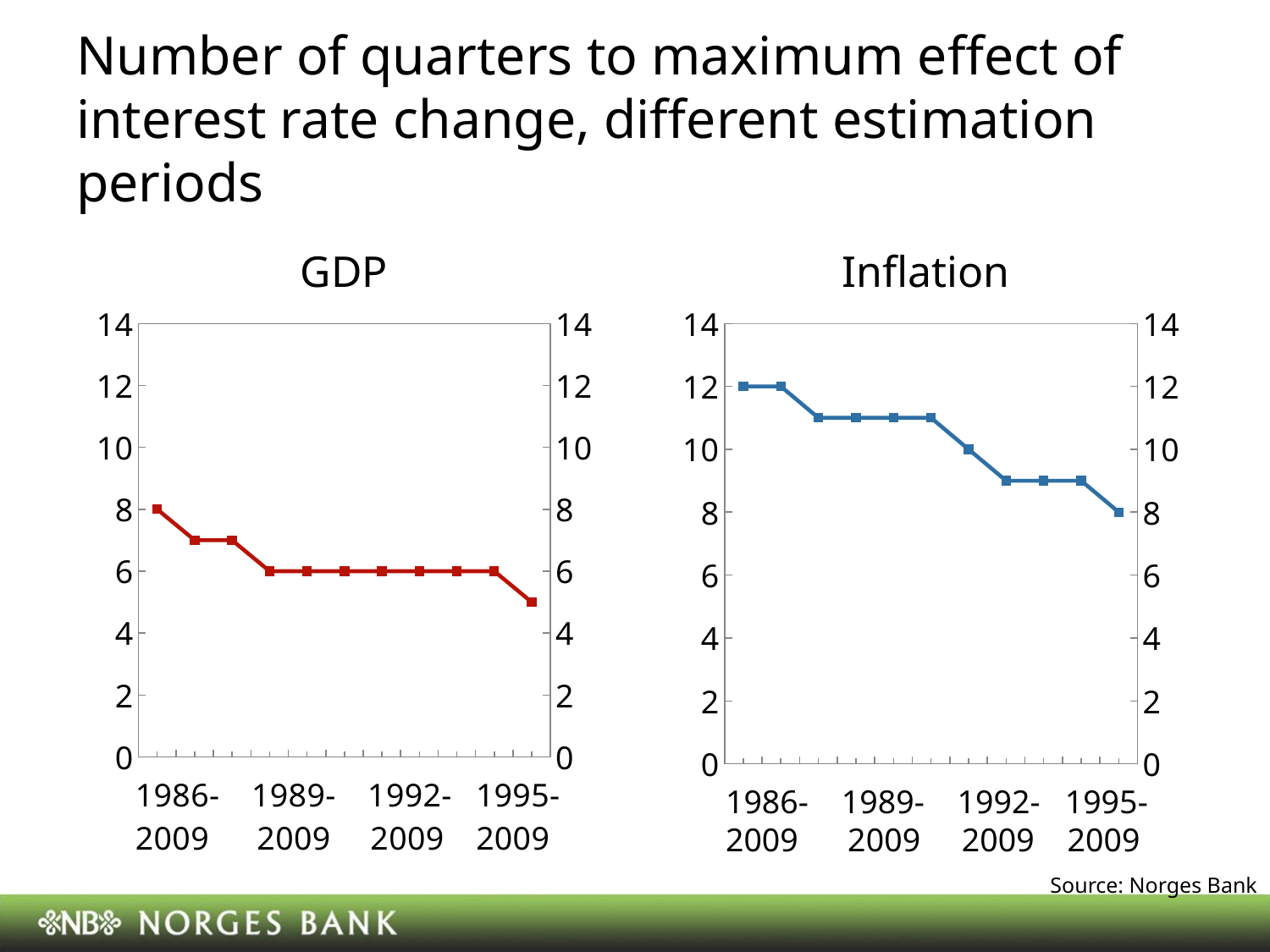
On the GDP chart, what is the difference between the values for 1986-2009 and 1989-2009? 2 On the Inflation chart, do the values rise or fall from left to right along the x axis? fall On the GDP chart, what is the value for the 1989-2009 estimation period? 6 Which is larger for the 1986-2009 period: the GDP chart value or the Inflation chart value? Inflation On the Inflation chart, what is the value for the 1992-2009 estimation period? 10 On the Inflation chart, is the value for 1995-2009 greater or less than 10? less On the GDP chart, which labelled estimation period has the highest value? 1986-2009 On the Inflation chart, what is the difference between the values for 1986-2009 and 1992-2009? 2 On the GDP chart, what is the value for the 1986-2009 estimation period? 8 What kind of chart is the GDP chart? line chart On the Inflation chart, what is the value for the 1986-2009 estimation period? 12 On the GDP chart, is the value for 1995-2009 greater or less than 8? less